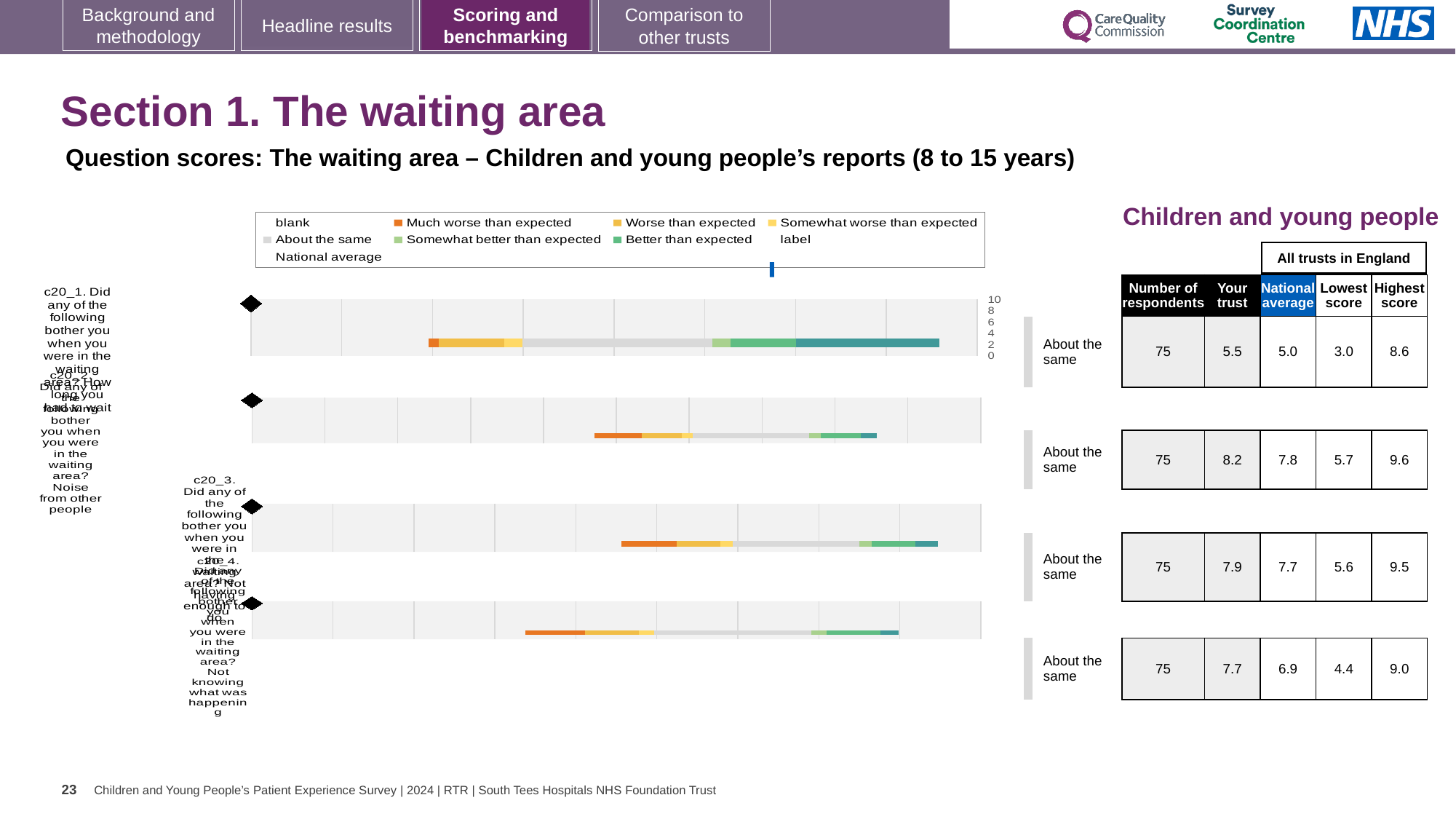
How many entries does the legend above the charts list? 9 What is the highest value shown on the score axis to the right of the top chart? 10 Which of the four charts has the highest 'Your trust' score in the table? the second chart (c20_2, noise from other people) What kind of chart is used to show the question scores on this slide? bar chart In the table, what is the 'Your trust' score for the top chart (c20_1, how long you had to wait)? 5.5 What colour does the legend use for 'Much worse than expected'? orange For the top chart (c20_1), what is the difference between the highest score and the lowest score in the table? 5.6 In the table, what is the national average for the second chart (c20_2, noise from other people)? 7.8 In the table, what is the number of respondents for the top chart (c20_1, how long you had to wait)? 75 What benchmark label is shown beside each of the four charts? About the same For the bottom chart (c20_4, not knowing what was happening), which is larger: the 'Your trust' score or the national average? Your trust How many separate bar charts are shown on the slide? 4